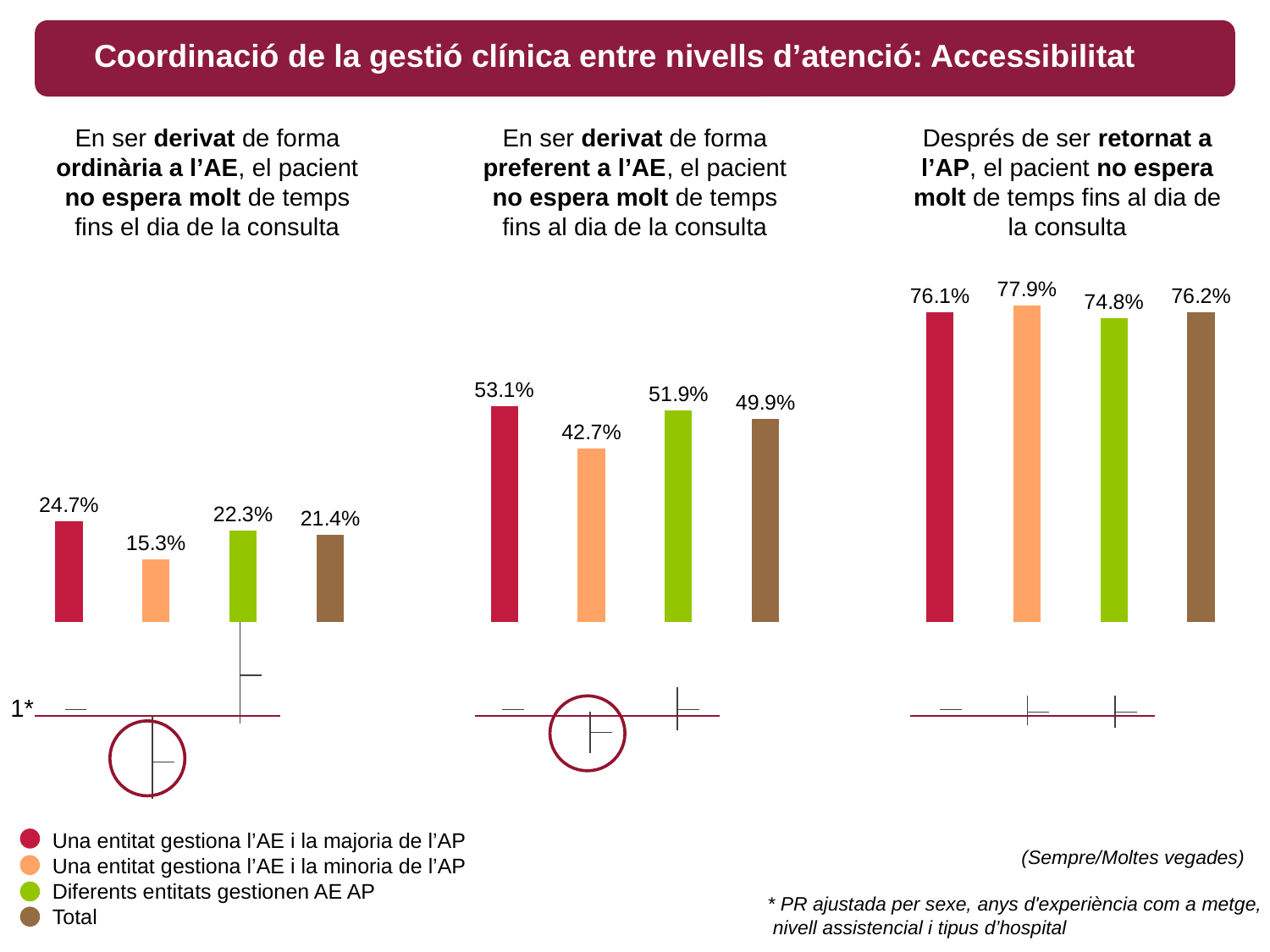
In the left chart (derivat de forma ordinària a l'AE), what is the value for 'Total'? 21.4% How many entries does the legend list? 4 In the left chart (derivat de forma ordinària a l'AE), what is the value for 'Una entitat gestiona l'AE i la majoria de l'AP'? 24.7% In the middle chart (derivat de forma preferent a l'AE), what is the value for 'Diferents entitats gestionen AE AP'? 51.9% How many bars does each of the three charts show? 4 In the right chart (retornat a l'AP), what is the value for 'Una entitat gestiona l'AE i la minoria de l'AP'? 77.9% In the right chart (retornat a l'AP), which category has the lowest value? Diferents entitats gestionen AE AP In the middle chart (derivat de forma preferent a l'AE), which category has the highest value? Una entitat gestiona l'AE i la majoria de l'AP In the middle chart (derivat de forma preferent a l'AE), what is the difference between 'Una entitat gestiona l'AE i la majoria de l'AP' and 'Una entitat gestiona l'AE i la minoria de l'AP'? 10.4 percentage points In the left chart (derivat de forma ordinària a l'AE), which category has the lowest value? Una entitat gestiona l'AE i la minoria de l'AP In the right chart (retornat a l'AP), which is larger: 'Una entitat gestiona l'AE i la minoria de l'AP' or 'Total'? Una entitat gestiona l'AE i la minoria de l'AP What kind of chart is used on this slide? Bar chart